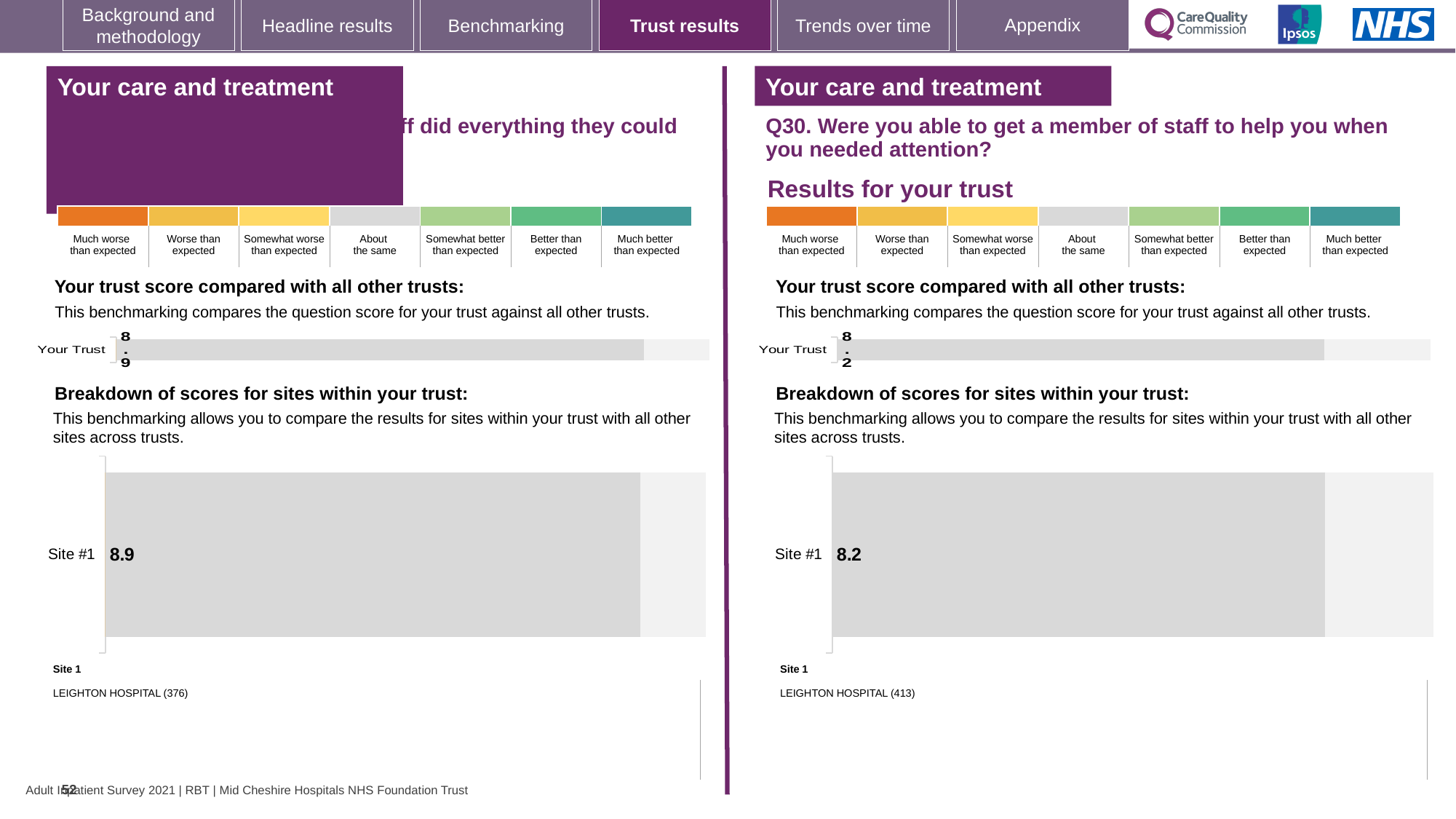
How many sites are shown in the left-hand panel's breakdown of scores for sites within your trust? 1 What kind of chart is used to show the Your Trust score in the Q30 panel? Bar chart In the left-hand panel's breakdown of scores for sites within your trust, what is the score for Site #1? 8.9 On the right-hand chart for Q30, what is the score shown for Your Trust? 8.2 In the Q30 panel, which hospital is listed as Site 1? LEIGHTON HOSPITAL (413) Is the Your Trust score in the Q30 panel greater or less than the Your Trust score in the left-hand panel? less In the Q30 breakdown of scores for sites within your trust, what is the score for Site #1? 8.2 On the left-hand panel, what is the score shown for Your Trust in the trust comparison bar? 8.9 In the left-hand panel, what number appears in brackets after LEIGHTON HOSPITAL under Site 1? 376 How many sites are shown in the Q30 breakdown of scores for sites within your trust? 1 What is the difference between the Site #1 score in the left-hand panel and the Site #1 score in the Q30 panel? 0.7 Which panel shows the higher Your Trust score, the left-hand panel or the right-hand Q30 panel? The left-hand panel